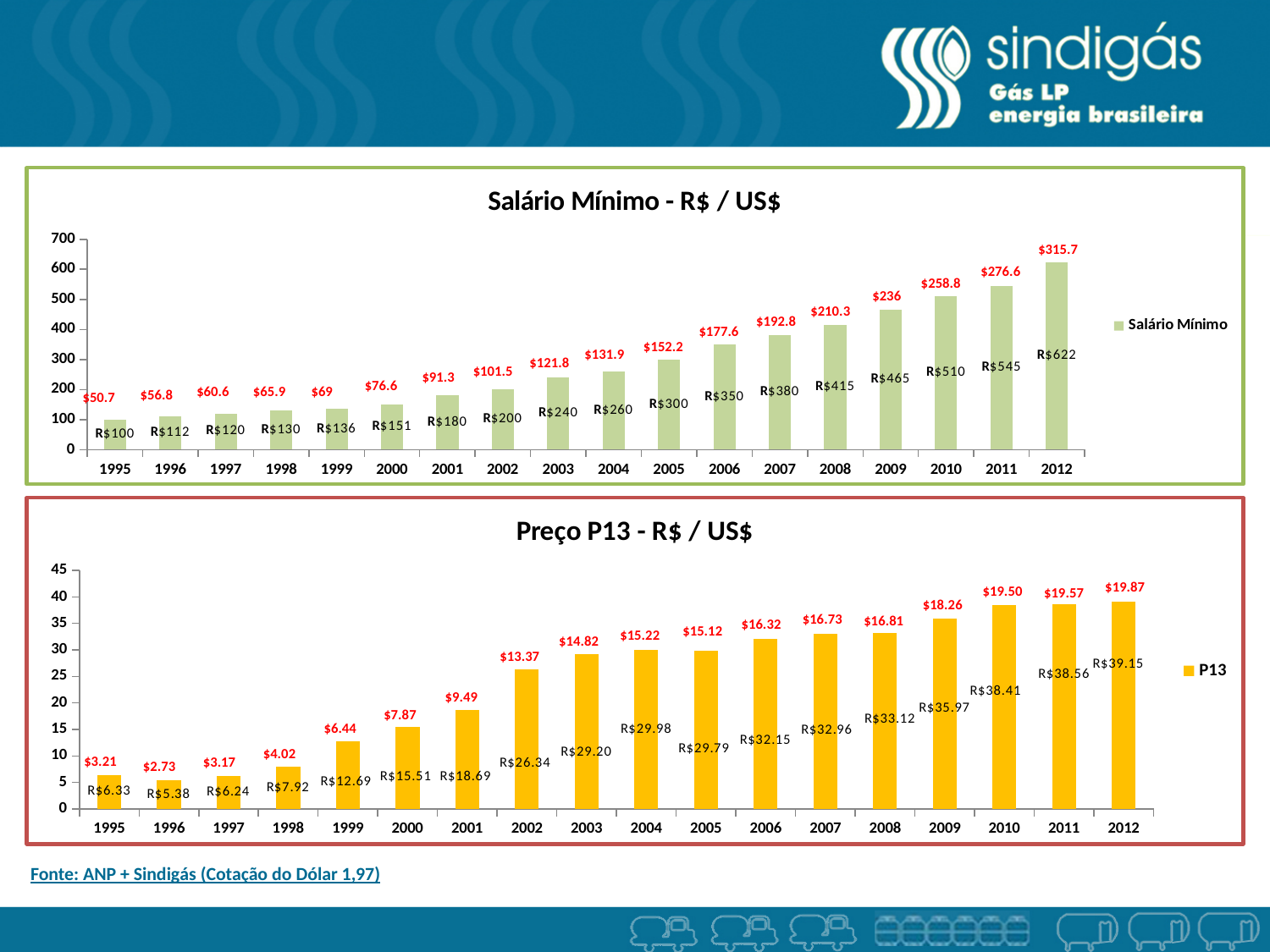
In the 'Salário Mínimo - R$ / US$' chart, how many years are shown on the x axis? 18 In the 'Salário Mínimo - R$ / US$' chart, which year has the lowest value? 1995 In the 'Preço P13 - R$ / US$' chart, which year has the lowest value? 1996 In the 'Preço P13 - R$ / US$' chart, which is larger, the value for 2004 or the value for 2001? 2004 What is the legend entry shown for the bottom chart? P13 In the 'Salário Mínimo - R$ / US$' chart, what is the R$ value shown for 2005? R$300 In the 'Preço P13 - R$ / US$' chart, what is the R$ value shown for 2002? R$26.34 In the 'Salário Mínimo - R$ / US$' chart, do the values rise or fall from 1995 to 2012? rise In the 'Salário Mínimo - R$ / US$' chart, what is the difference in R$ between 2012 and 2011? R$77 In the 'Salário Mínimo - R$ / US$' chart, what is the US$ value labelled for 2012? $315.7 In the 'Preço P13 - R$ / US$' chart, what is the US$ value labelled for 1999? $6.44 What type of chart is the 'Preço P13 - R$ / US$' chart? bar chart